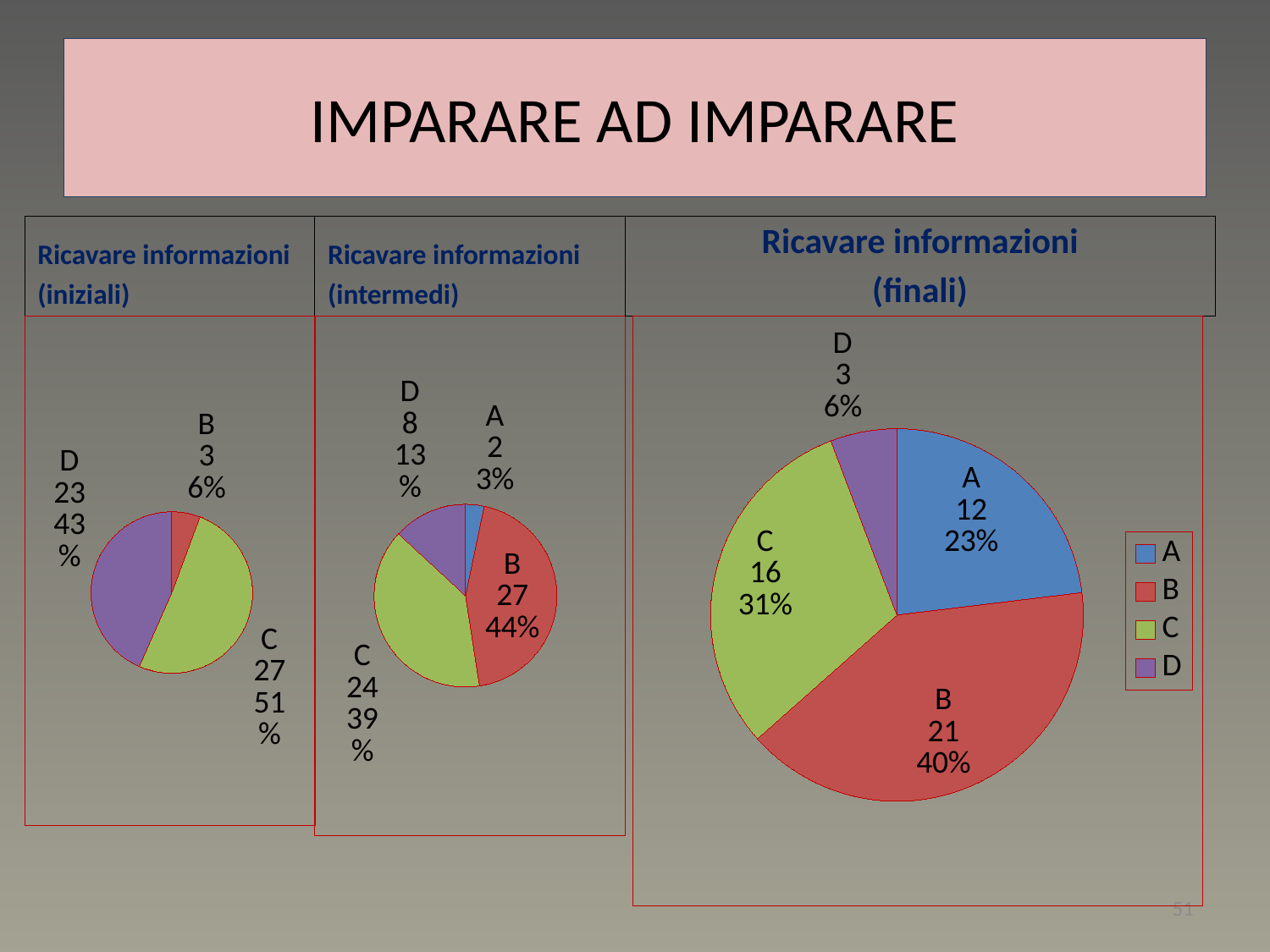
In the 'Ricavare informazioni (intermedi)' chart, which category has the smallest slice? A In the 'Ricavare informazioni (iniziali)' chart, what percentage share does slice D have? 43% How many categories does the legend of the 'Ricavare informazioni (finali)' chart list? 4 In the 'Ricavare informazioni (intermedi)' chart, which is larger, the value for B or the value for C? B In the 'Ricavare informazioni (finali)' chart, what is the value for B? 21 In the 'Ricavare informazioni (finali)' chart, which category has the largest slice? B In the 'Ricavare informazioni (intermedi)' chart, what is the value for D? 8 In the 'Ricavare informazioni (iniziali)' chart, which category has the largest slice? C In the 'Ricavare informazioni (finali)' chart, what colour is the slice for C? green In the 'Ricavare informazioni (finali)' chart, what is the difference between the values for B and A? 9 What kind of chart is used in the 'Ricavare informazioni (finali)' panel? pie chart In the 'Ricavare informazioni (finali)' chart, what percentage share does slice C have? 31%